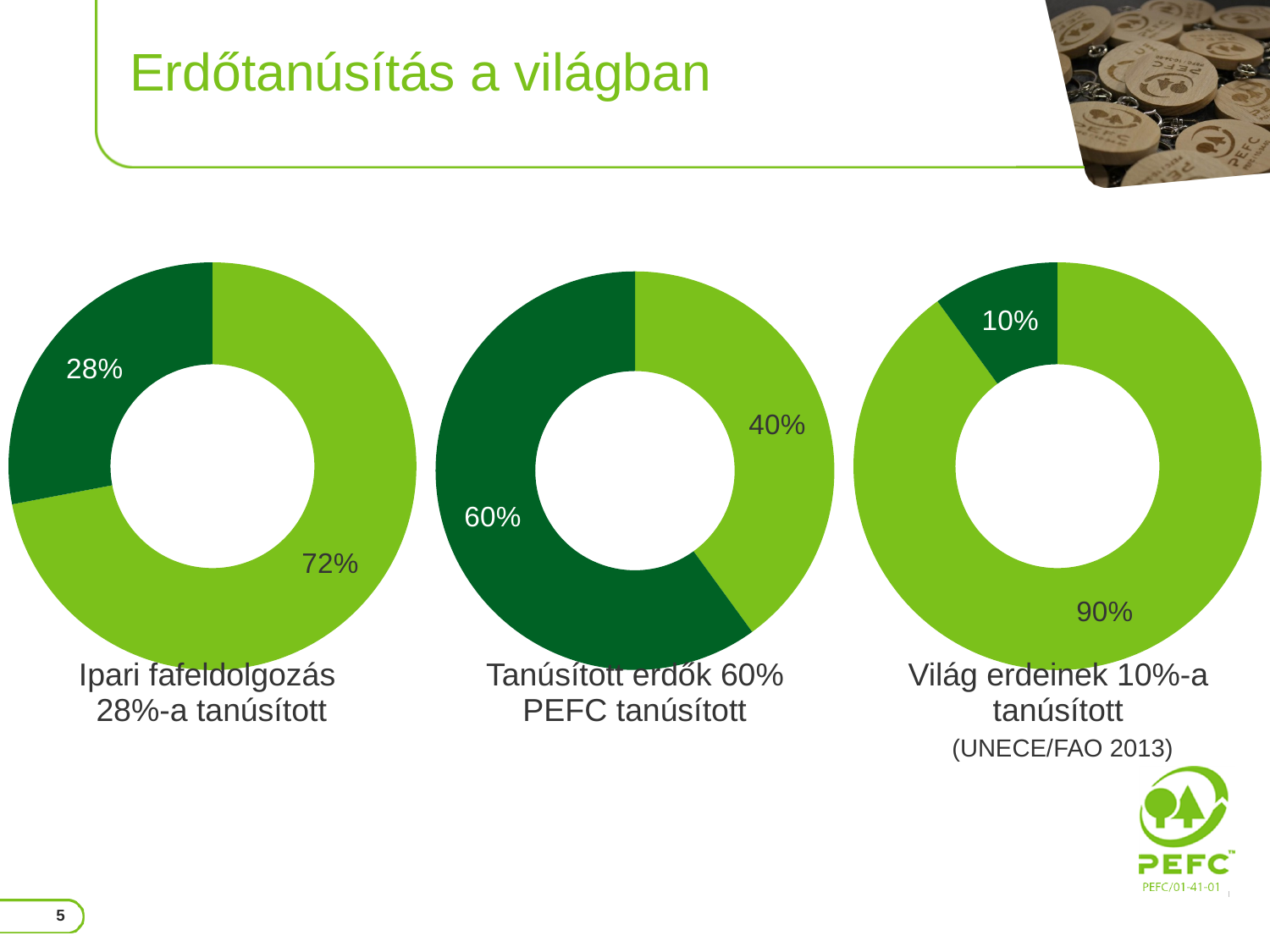
What kind of chart is used for the three charts on the slide? Donut (pie) chart What source is cited below the right chart? UNECE/FAO 2013 In the middle chart (Tanúsított erdők), which slice is larger, the dark green or the light green one? Dark green (60%) In the middle chart (Tanúsított erdők), what value is shown for the light green slice? 40% In the right chart (Világ erdeinek), what value is shown for the light green slice? 90% How many charts are shown on the slide? 3 In the middle chart (Tanúsított erdők), what value is shown for the dark green slice? 60% In the left chart (Ipari fafeldolgozás), what value is shown for the dark green slice? 28% In the left chart (Ipari fafeldolgozás), what is the difference between the light green and dark green slice values? 44% In the left chart (Ipari fafeldolgozás), what value is shown for the light green slice? 72% In the right chart (Világ erdeinek), what value is shown for the dark green slice? 10% How many slices does each donut chart on the slide have? 2